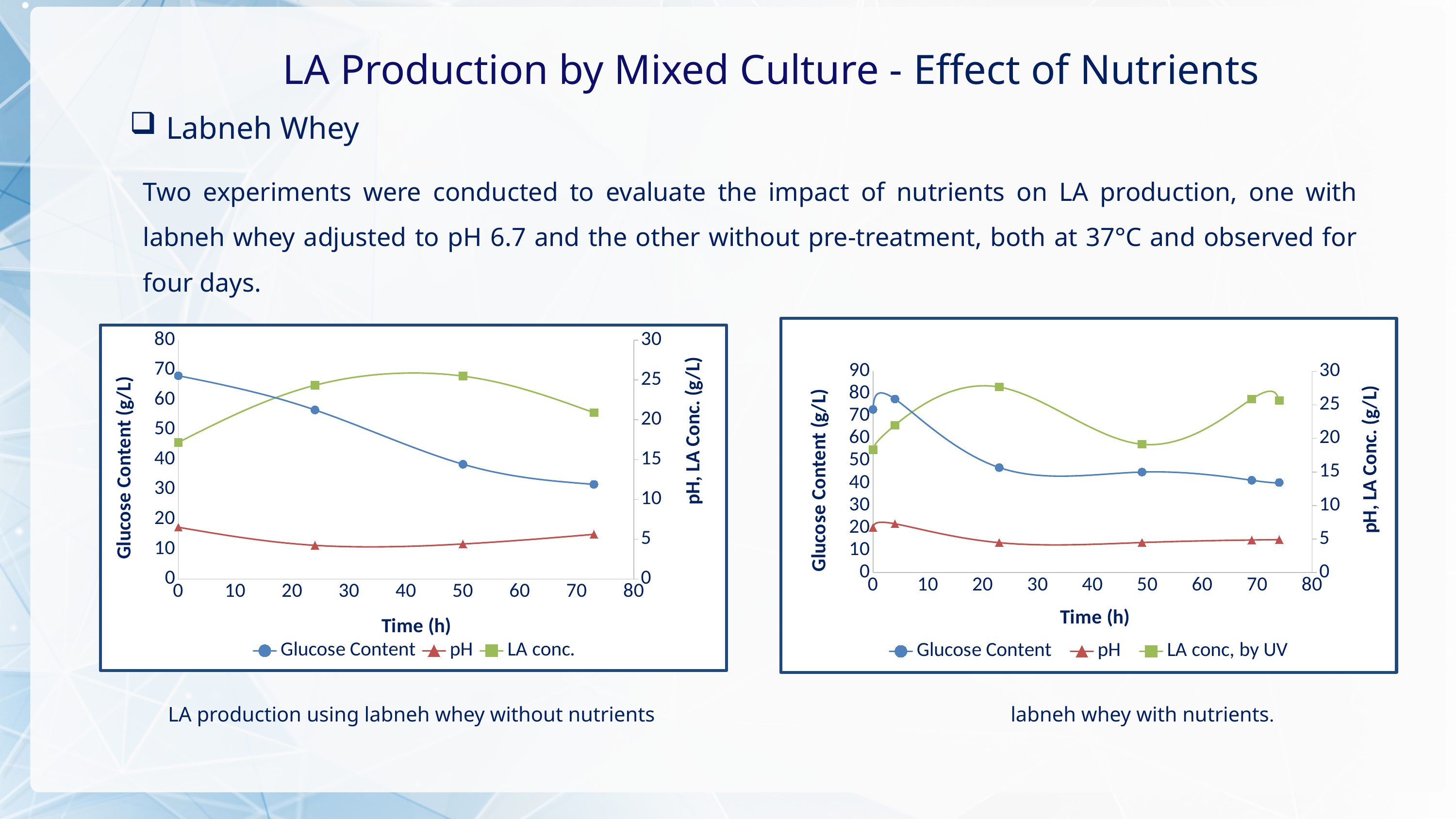
What is the label of the green square series in the legend of the right chart (with nutrients)? LA conc, by UV In the left chart (without nutrients), how many data points are plotted for the Glucose Content series? 4 In the left chart (without nutrients), which is larger: the LA conc. at 50 h or the LA conc. at 0 h? LA conc. at 50 h In the left chart (without nutrients), is the Glucose Content value at the last time point greater or less than 40 g/L? less What is the x-axis title of the left chart (without nutrients)? Time (h) How many series does the legend of the right chart (labneh whey with nutrients) list? 3 In the right chart (with nutrients), is the LA conc. value at time 0 greater or less than 20 g/L? less What kind of chart is the left chart (LA production using labneh whey without nutrients)? line chart In the left chart (without nutrients), is the Glucose Content value at time 0 greater or less than 60 g/L? greater In the left chart (without nutrients), does Glucose Content rise or fall over time? fall In the right chart (with nutrients), how many data points are plotted for the Glucose Content series? 6